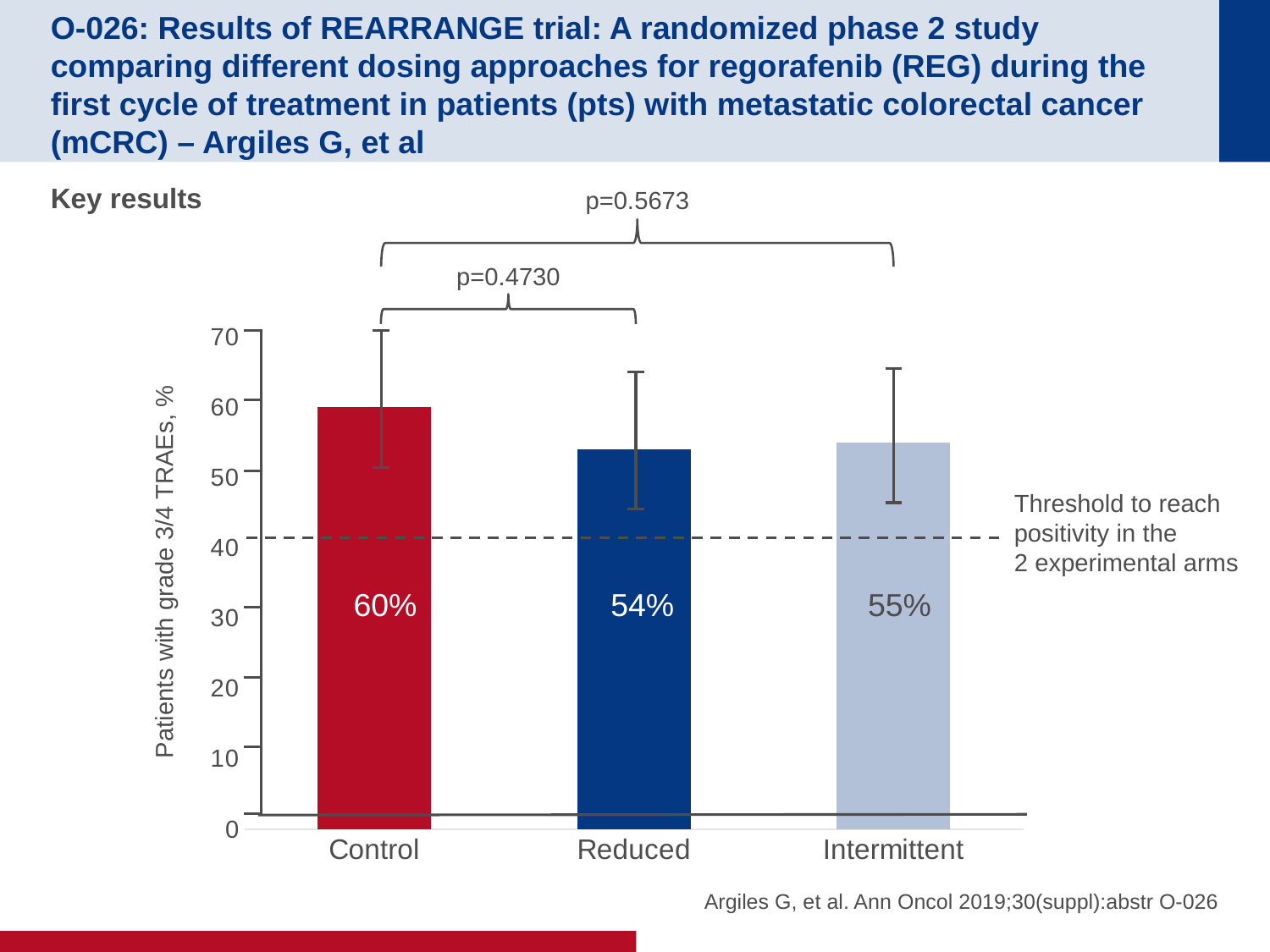
Which arm has the highest percentage of patients with grade 3/4 TRAEs? Control What percentage of patients had grade 3/4 TRAEs in the Intermittent arm? 55% Which arm has a higher percentage of patients with grade 3/4 TRAEs, Control or Intermittent? Control What is the label of the y axis? Patients with grade 3/4 TRAEs, % What p-value is shown for the comparison between the Control and Reduced arms? p=0.4730 What percentage of patients had grade 3/4 TRAEs in the Control arm? 60% How many treatment arms are shown on the x axis? 3 Which arm has the lowest percentage of patients with grade 3/4 TRAEs? Reduced What kind of chart is shown on the slide? Bar chart What percentage of patients had grade 3/4 TRAEs in the Reduced arm? 54% What is the difference in percentage points between the Control and Reduced arms? 6 percentage points Is the value for the Reduced arm greater or less than 40? greater